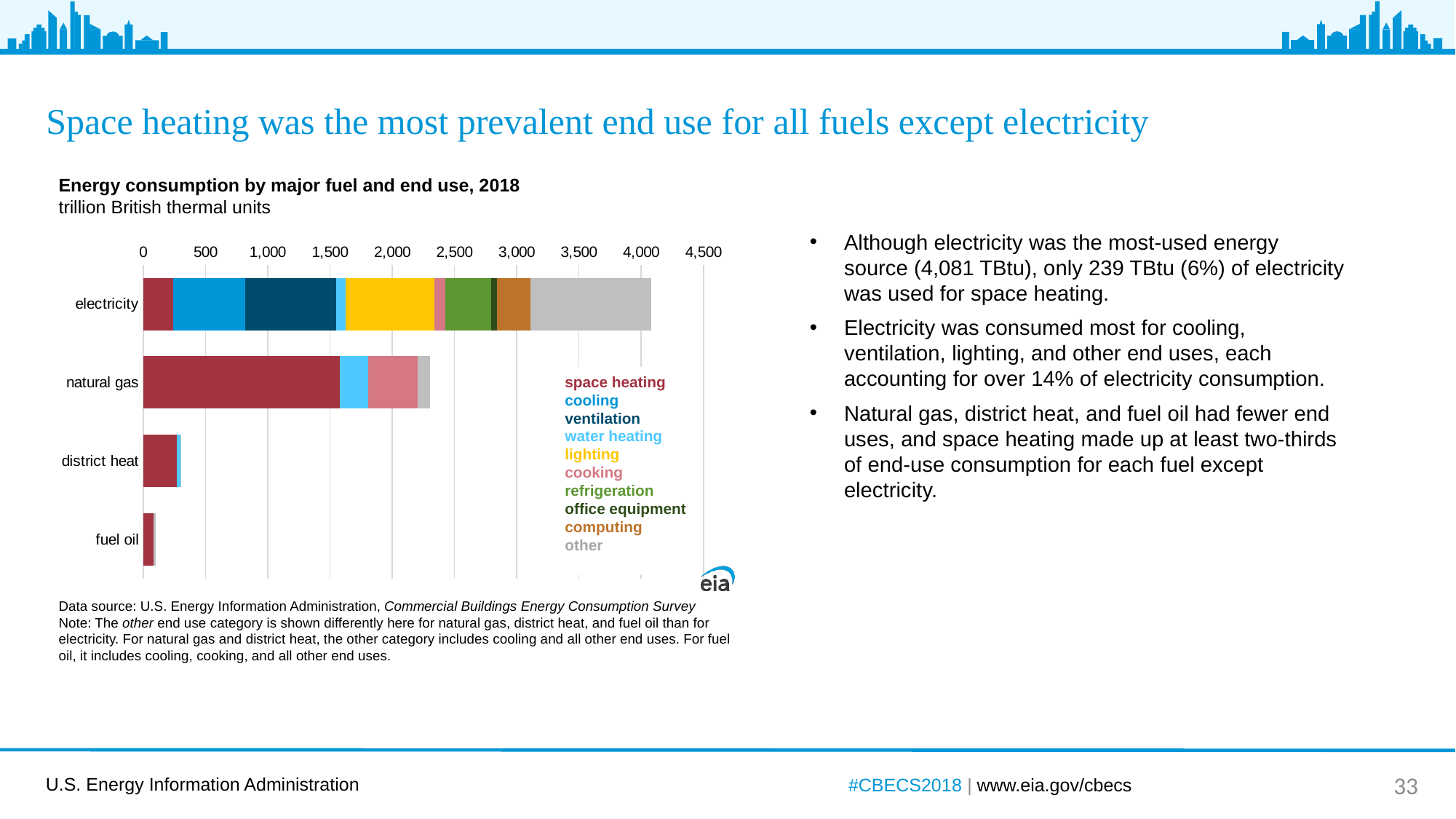
Which has a larger total bar, natural gas or district heat? natural gas What unit is the chart measured in, according to the subtitle? trillion British thermal units What is the title of the chart? Energy consumption by major fuel and end use, 2018 How many end-use series does the legend list? 10 How many fuel categories are plotted on the chart? 4 Is the total value for district heat greater or less than 500? less Which fuel has the largest total energy consumption? electricity What kind of chart is shown on the slide? stacked bar chart Is the total value for electricity greater or less than 4,000? greater Is the total value for natural gas greater or less than 2,000? greater Which fuel has the smallest total energy consumption? fuel oil